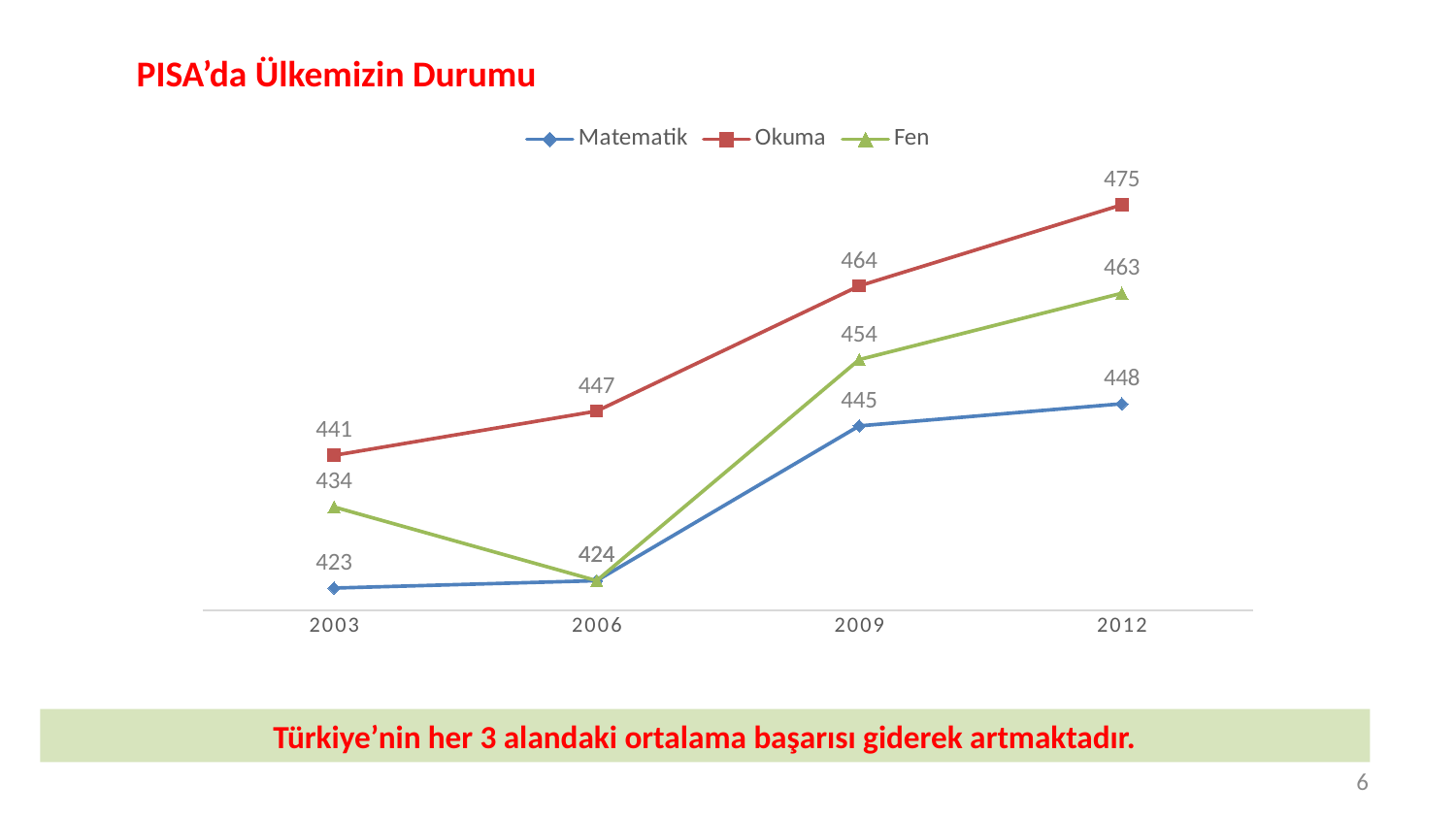
How many series does the legend list? 3 What is the Fen value for 2009? 454 What type of chart is shown on the slide? line chart What is the Okuma value for 2012? 475 In which year is the Matematik value lowest? 2003 What is the title of the slide containing the chart? PISA'da Ülkemizin Durumu In which year is the Okuma value highest? 2012 Which is larger in 2009, the Okuma value or the Fen value? Okuma Does the Okuma series rise or fall from 2003 to 2012? rise What is the Matematik value for 2003? 423 What is the difference between the Okuma value in 2012 and the Okuma value in 2003? 34 How many years are shown on the x axis? 4